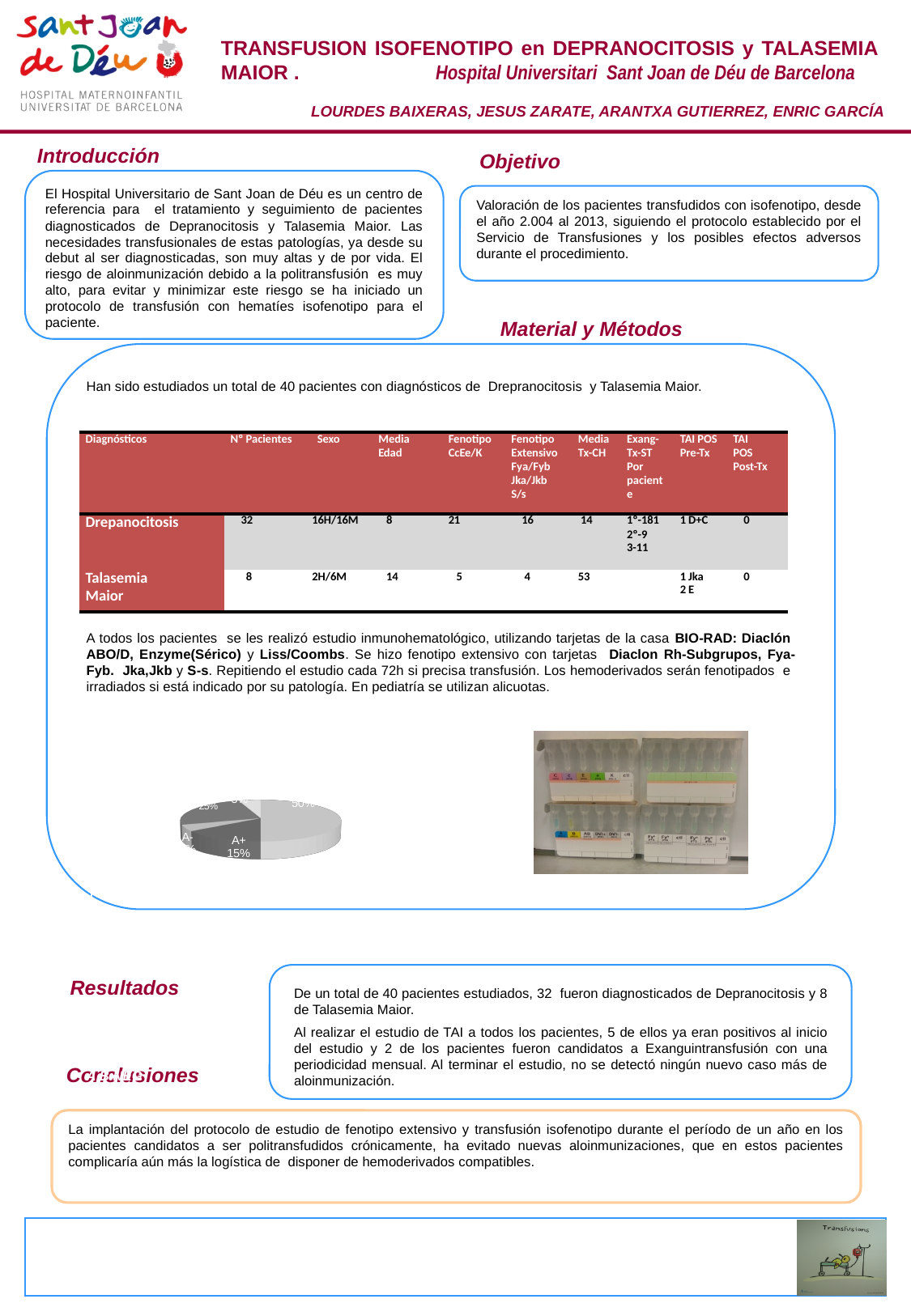
In the pie chart, what share is labelled for A+? 15% In the pie chart, is the share for A+ greater or less than 50%? less What kind of chart is shown on the slide? pie chart